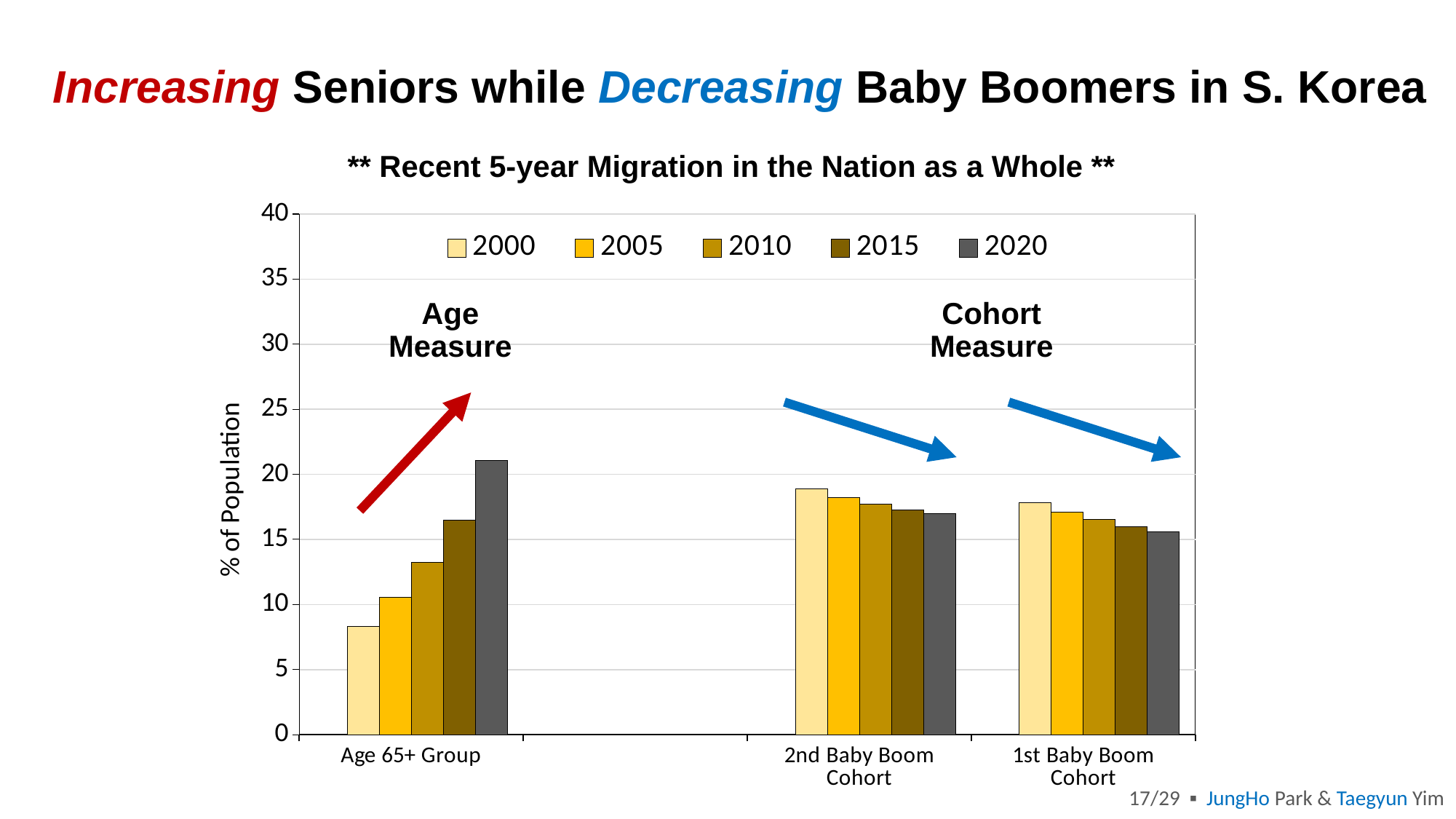
For the 1st Baby Boom Cohort, which year has the lowest value? 2020 Which is larger: the 2020 value for the Age 65+ Group or the 2020 value for the 2nd Baby Boom Cohort? Age 65+ Group Is the 2020 value for the Age 65+ Group greater or less than 20? greater How many series does the legend list? 5 Is the 2000 value for the Age 65+ Group greater or less than 10? less For the 2nd Baby Boom Cohort, which year has the highest value? 2000 What kind of chart is shown on the slide? Bar chart For the Age 65+ Group, which year has the lowest value? 2000 For the Age 65+ Group, which year has the highest value? 2020 Do the values for the Age 65+ Group rise or fall from 2000 to 2020? Rise What is the label of the y axis? % of Population How many categories are shown on the x axis? 3